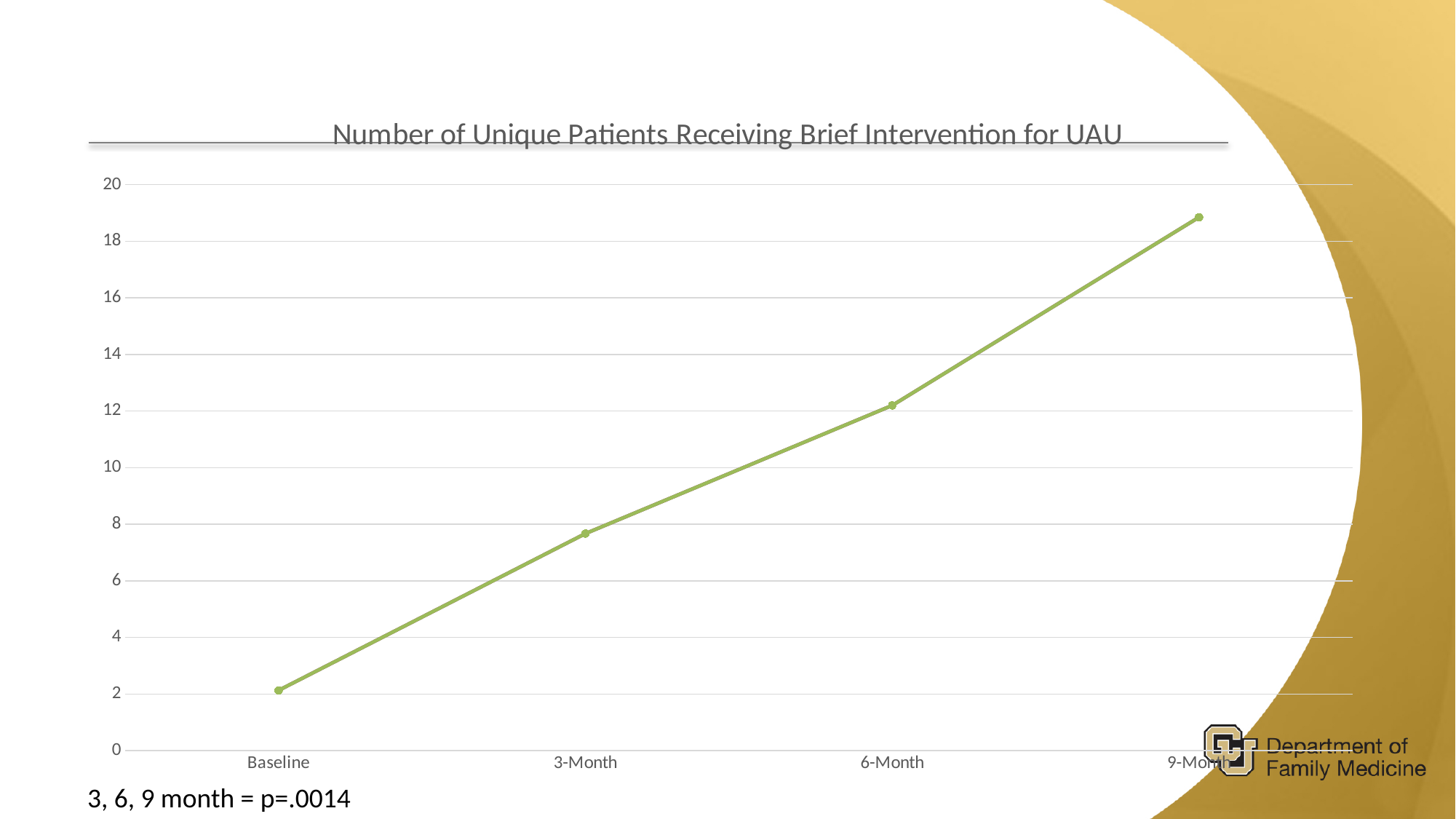
Is the value at 6-Month greater or less than 14? less Which time point has the highest value? 9-Month What is the title of the chart? Number of Unique Patients Receiving Brief Intervention for UAU Is the value at 9-Month greater or less than 16? greater What type of chart is shown on the slide? Line chart Is the value at 3-Month greater or less than 6? greater Which is larger, the value at 3-Month or the value at 6-Month? 6-Month Which time point has the lowest value? Baseline How many time points are plotted on the x axis? 4 Do the values rise or fall from Baseline to 9-Month? Rise